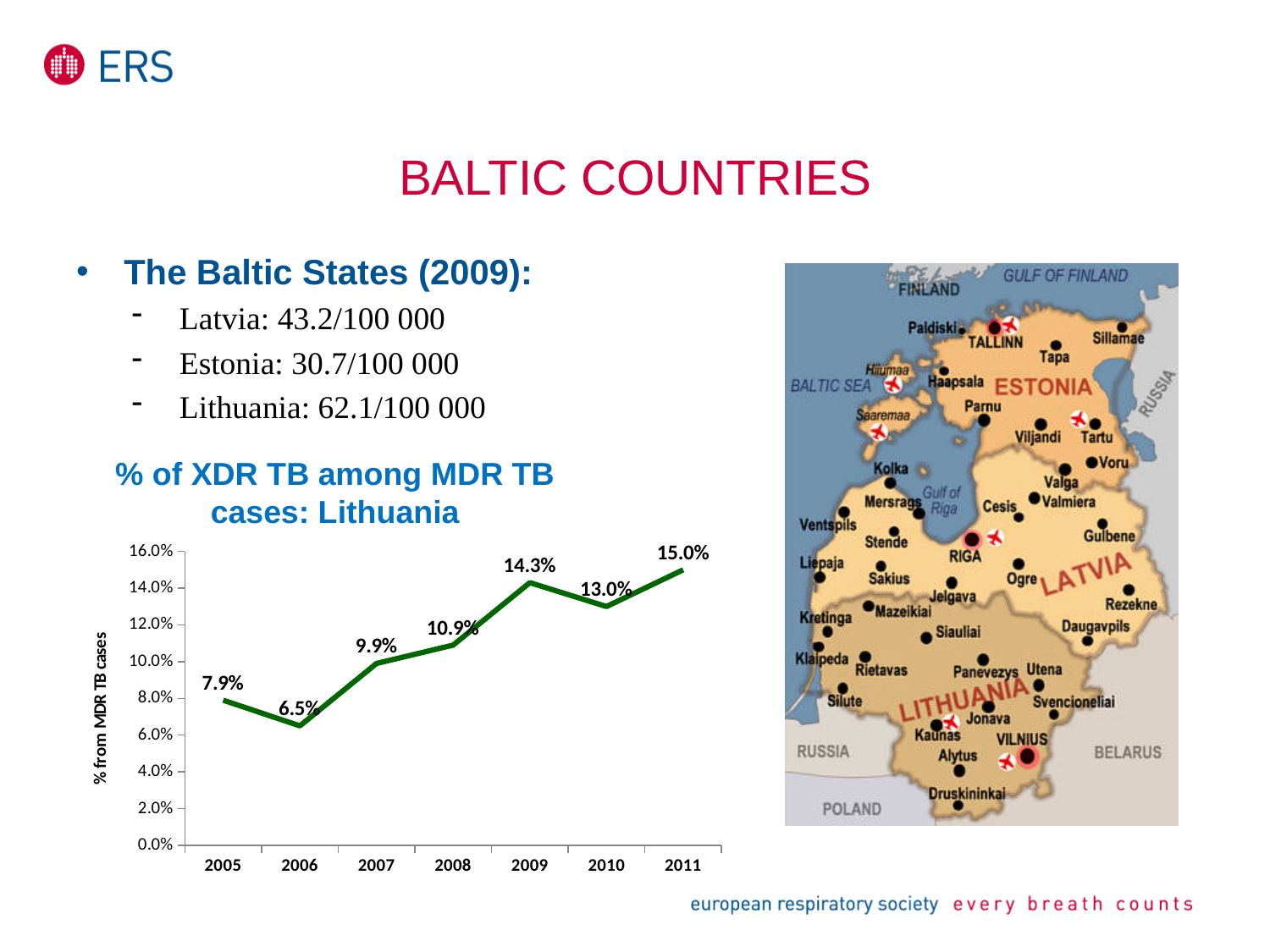
What kind of chart is shown on the slide? line chart What is the difference between the values for 2009 and 2010? 1.3% Which is larger, the value for 2007 or the value for 2008? 2008 Which year has the lowest value in the chart? 2006 Is the value for 2010 greater or less than 12.0%? greater What is the value for 2011 in the chart? 15.0% What is the value for 2009 in the chart? 14.3% What is the value for 2005 in the chart? 7.9% What is the difference between the values for 2011 and 2005? 7.1% Which year has the highest value in the chart? 2011 What is the title of the chart? % of XDR TB among MDR TB cases: Lithuania How many years are plotted in the chart? 7